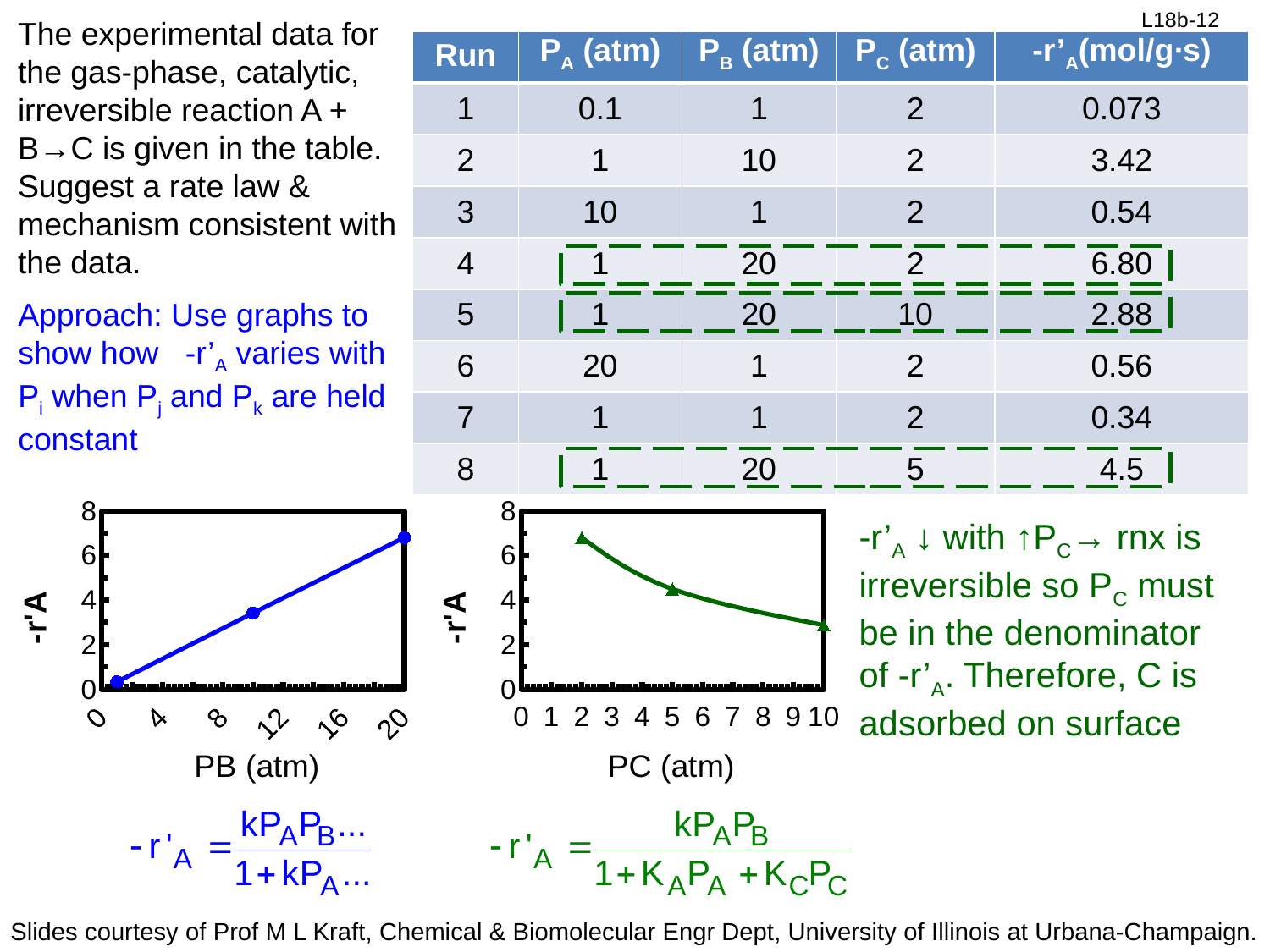
What is the x-axis title of the left chart? PB (atm) In the right chart (-r'A vs PC), is the value of -r'A at PC = 2 greater or less than 6? greater In the right chart (-r'A vs PC), how many data points are plotted? 3 In the left chart (-r'A vs PB), does -r'A rise or fall as PB increases? rise In the left chart (-r'A vs PB), is the value of -r'A at PB = 20 greater or less than 6? greater In the left chart (-r'A vs PB), is the value of -r'A at the lowest PB point greater or less than 2? less What kind of chart is the left chart (-r'A vs PB)? line chart What colour is the line in the right chart (-r'A vs PC)? green In the right chart (-r'A vs PC), what is the PC value of the rightmost data point? 10 In the left chart (-r'A vs PB), how many data points are plotted? 3 In the right chart (-r'A vs PC), does -r'A rise or fall as PC increases? fall